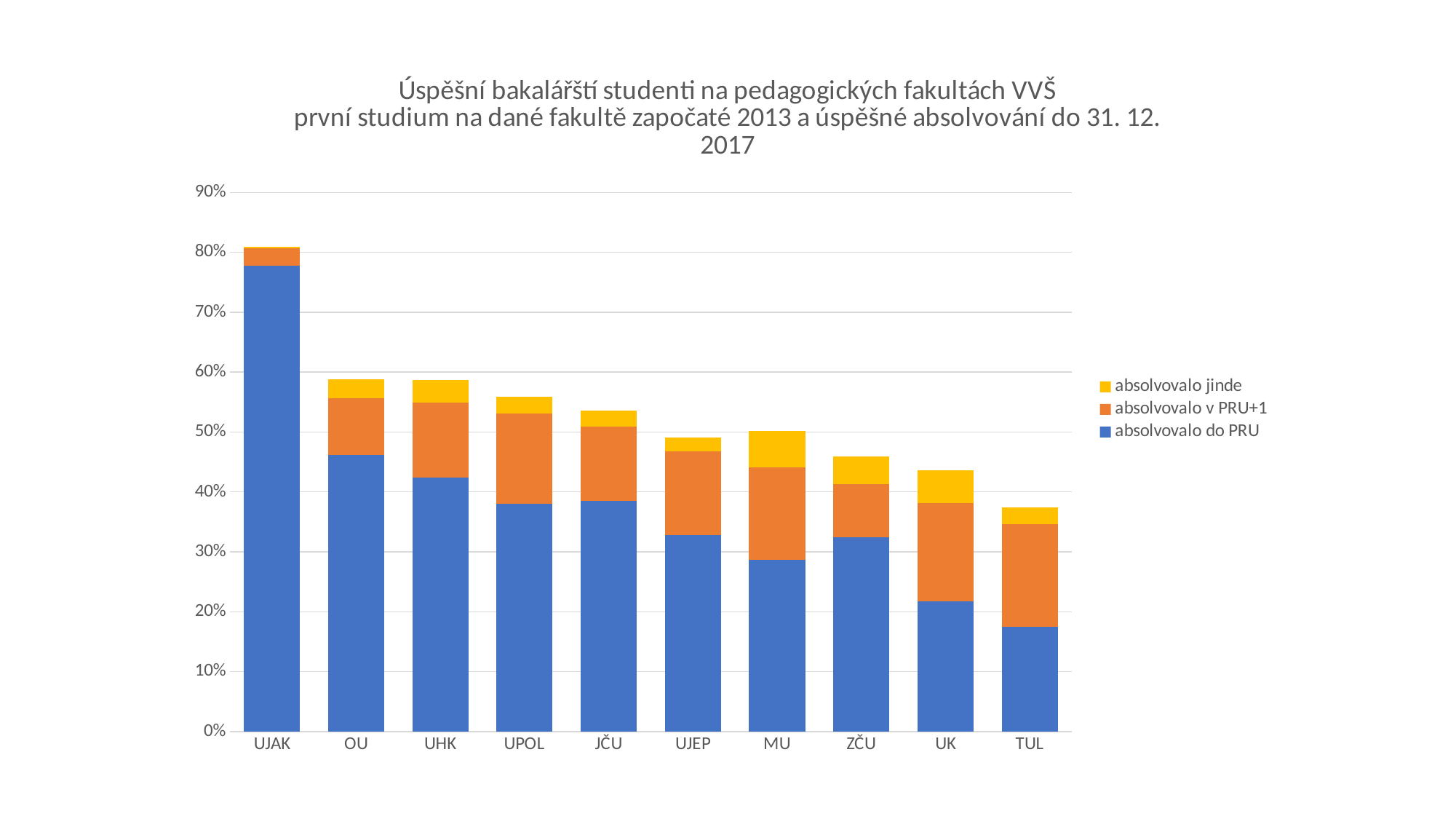
Which faculty has the smallest 'absolvovalo do PRU' segment? TUL Which faculty has the lowest total stacked bar? TUL Which colour represents the 'absolvovalo jinde' series in the legend? yellow Which has the larger 'absolvovalo do PRU' segment, MU or UK? MU How many series does the legend list? 3 Is the total stacked bar for OU greater or less than 60%? less Which faculty has the highest total stacked bar? UJAK Is the 'absolvovalo do PRU' value for UJAK greater or less than 70%? greater Is the total stacked bar for UK greater or less than 40%? greater What kind of chart is shown on the slide? stacked bar chart How many faculties (categories) are shown on the x axis? 10